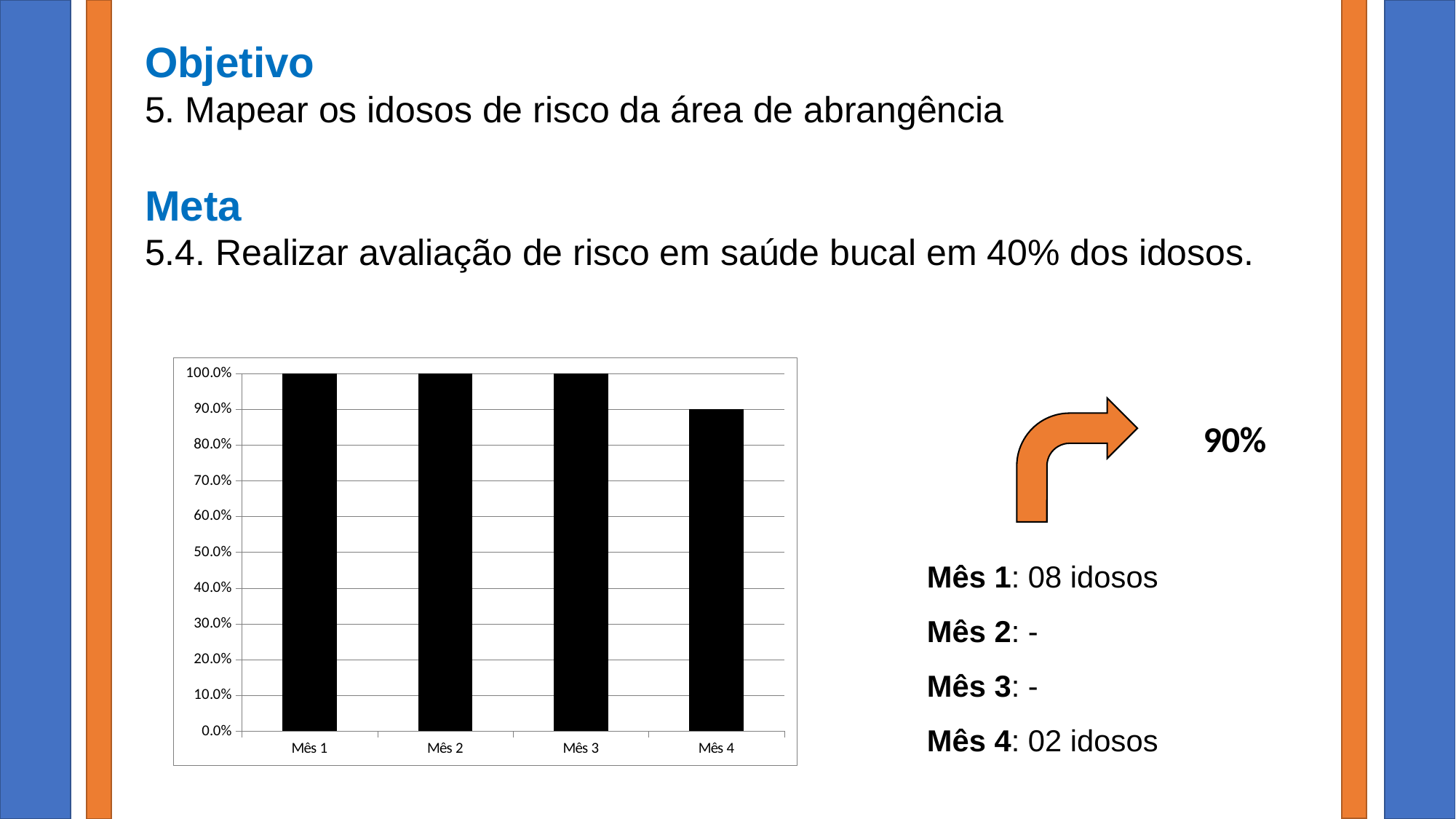
What is the value for Mês 4 in the chart? 90.0% What is the value for Mês 1 in the chart? 100.0% Which is larger, the value for Mês 2 or the value for Mês 4? Mês 2 Do the values rise or fall from Mês 3 to Mês 4? fall What colour are the bars in the chart? black What kind of chart is shown on the slide? bar chart Is the value for Mês 4 greater or less than 50.0%? greater How many bars (categories) does the chart show? 4 What is the difference between the value for Mês 1 and the value for Mês 4? 10.0% What is the label of the first category on the x axis? Mês 1 Which category has the lowest value in the chart? Mês 4 What is the value for Mês 3 in the chart? 100.0%